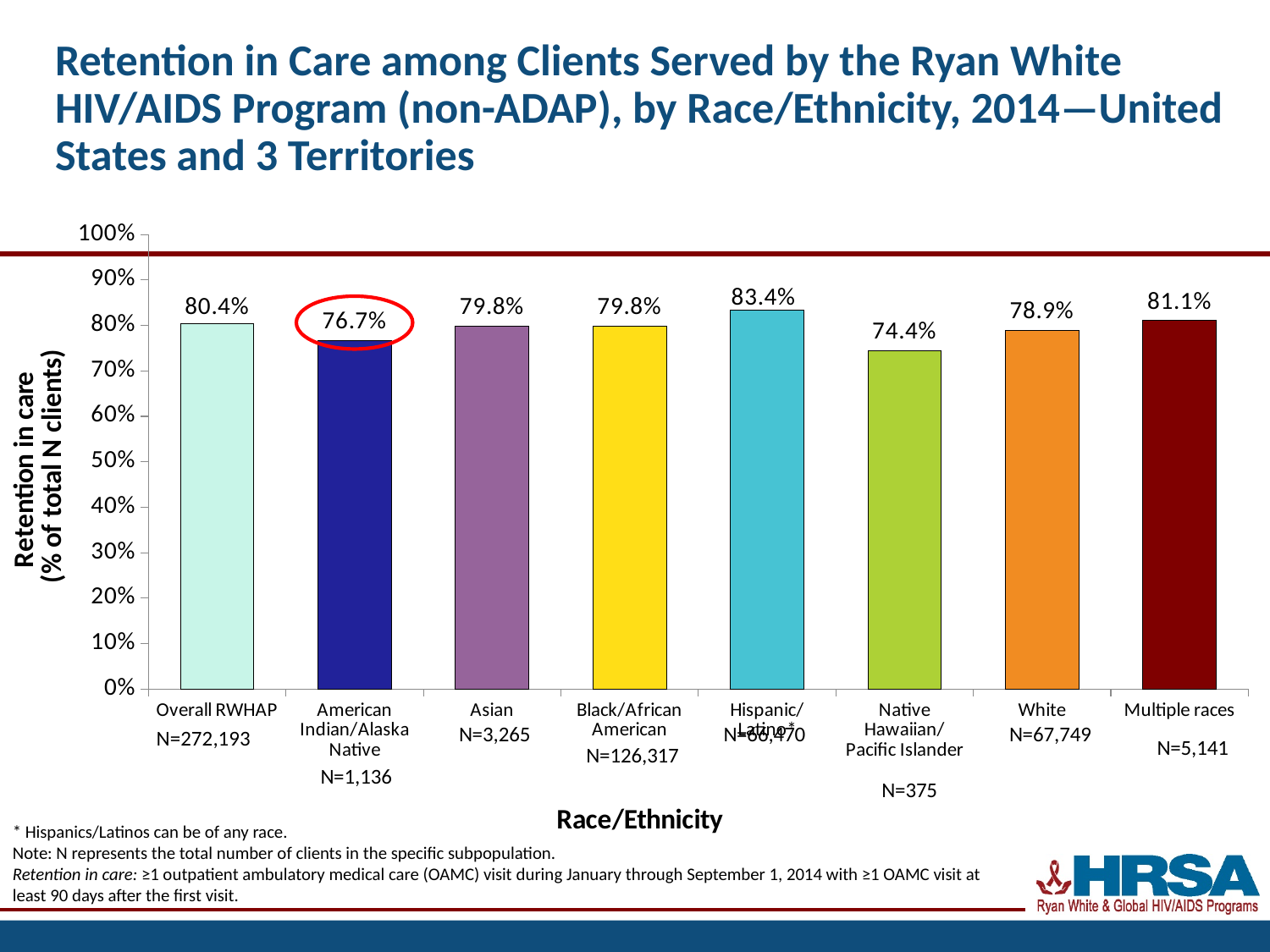
What is the retention in care value for Overall RWHAP? 80.4% Which race/ethnicity category has the highest retention in care? Hispanic/Latino What is the difference in retention in care between Hispanic/Latino and Native Hawaiian/Pacific Islander clients? 9.0% How many race/ethnicity categories are shown in the chart? 8 What is the retention in care value for Hispanic/Latino clients? 83.4% What is the retention in care value for Native Hawaiian/Pacific Islander clients? 74.4% Is the retention in care value for Asian clients greater or less than 70%? greater What type of chart is shown on the slide? Bar chart What is the difference in retention in care between Multiple races and American Indian/Alaska Native clients? 4.4% Which race/ethnicity category has the lowest retention in care? Native Hawaiian/Pacific Islander Which has a higher retention in care, Multiple races or White? Multiple races What is the retention in care value for White clients? 78.9%